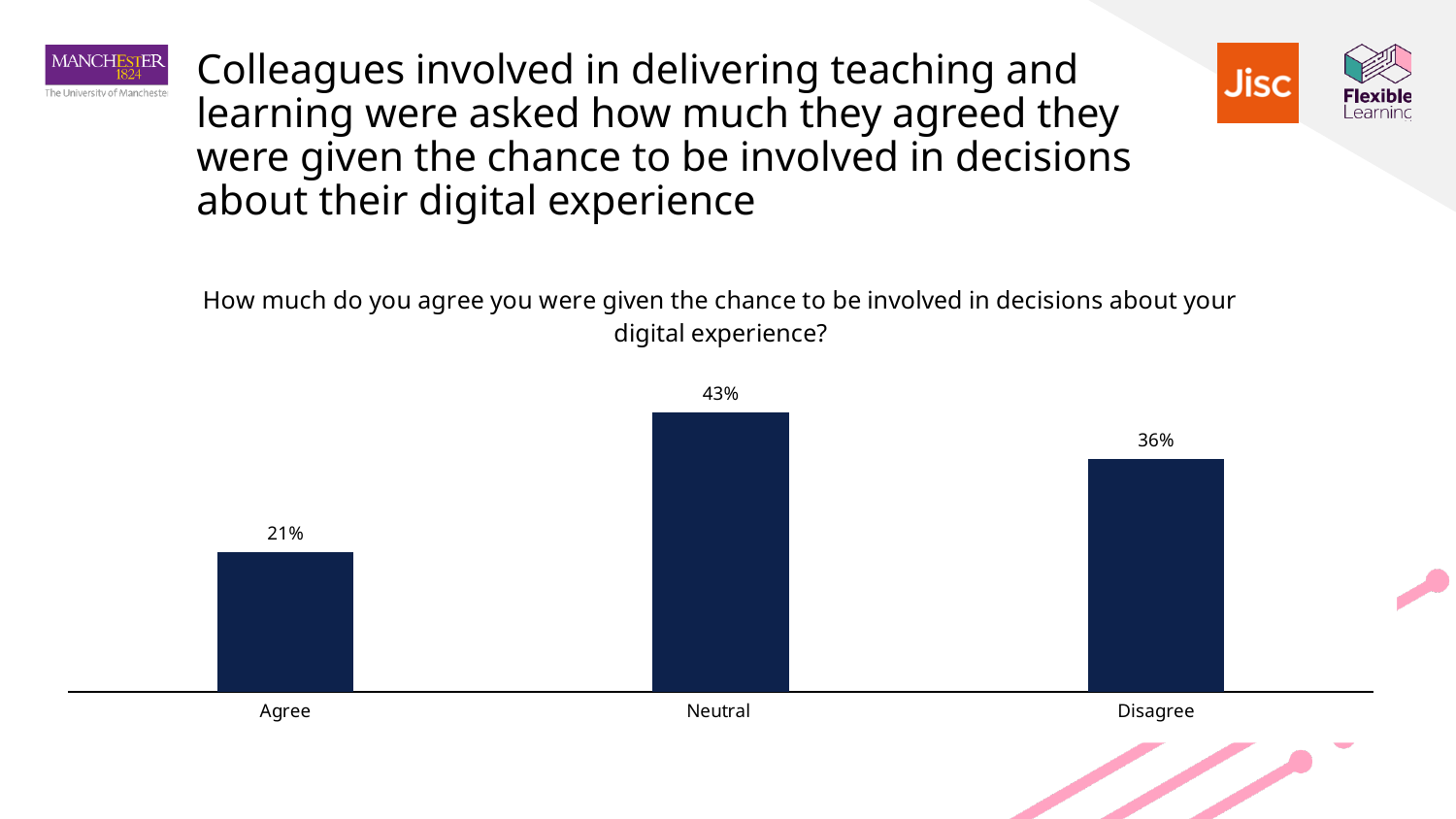
What is the title of the chart? How much do you agree you were given the chance to be involved in decisions about your digital experience? What percentage of respondents answered Neutral? 43% What is the difference in percentage points between Disagree and Agree? 15 Which is larger, the percentage for Disagree or the percentage for Agree? Disagree What is the difference in percentage points between Neutral and Agree? 22 What type of chart is shown on the slide? Bar chart What colour are the bars in the chart? Dark navy blue Which response category has the highest percentage? Neutral What percentage of respondents answered Disagree? 36% Which response category has the lowest percentage? Agree What percentage of respondents answered Agree? 21% How many response categories are shown on the chart? 3